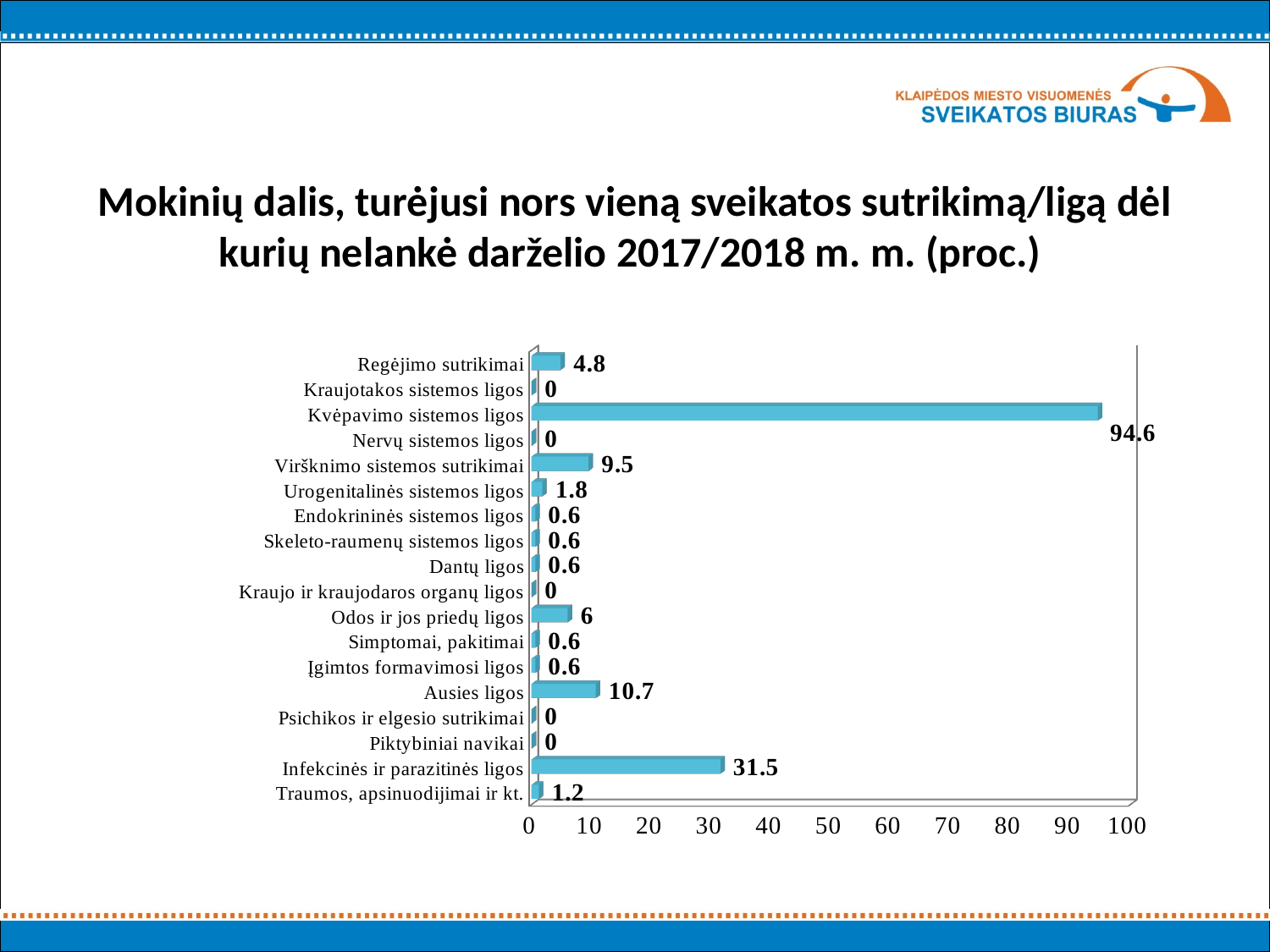
How many categories are shown on the chart? 18 What is the difference between the values for Kvėpavimo sistemos ligos and Infekcinės ir parazitinės ligos? 63.1 What is the value for Infekcinės ir parazitinės ligos? 31.5 What is the maximum value shown on the horizontal axis? 100 Is the value for Infekcinės ir parazitinės ligos greater or less than 30? greater What is the value for Regėjimo sutrikimai? 4.8 What is the value for Urogenitalinės sistemos ligos? 1.8 What is the value for Kvėpavimo sistemos ligos? 94.6 Which category has the highest value? Kvėpavimo sistemos ligos What is the value for Ausies ligos? 10.7 Which is larger, the value for Virškinimo sistemos sutrikimai or the value for Odos ir jos priedų ligos? Virškinimo sistemos sutrikimai What kind of chart is shown on the slide? bar chart